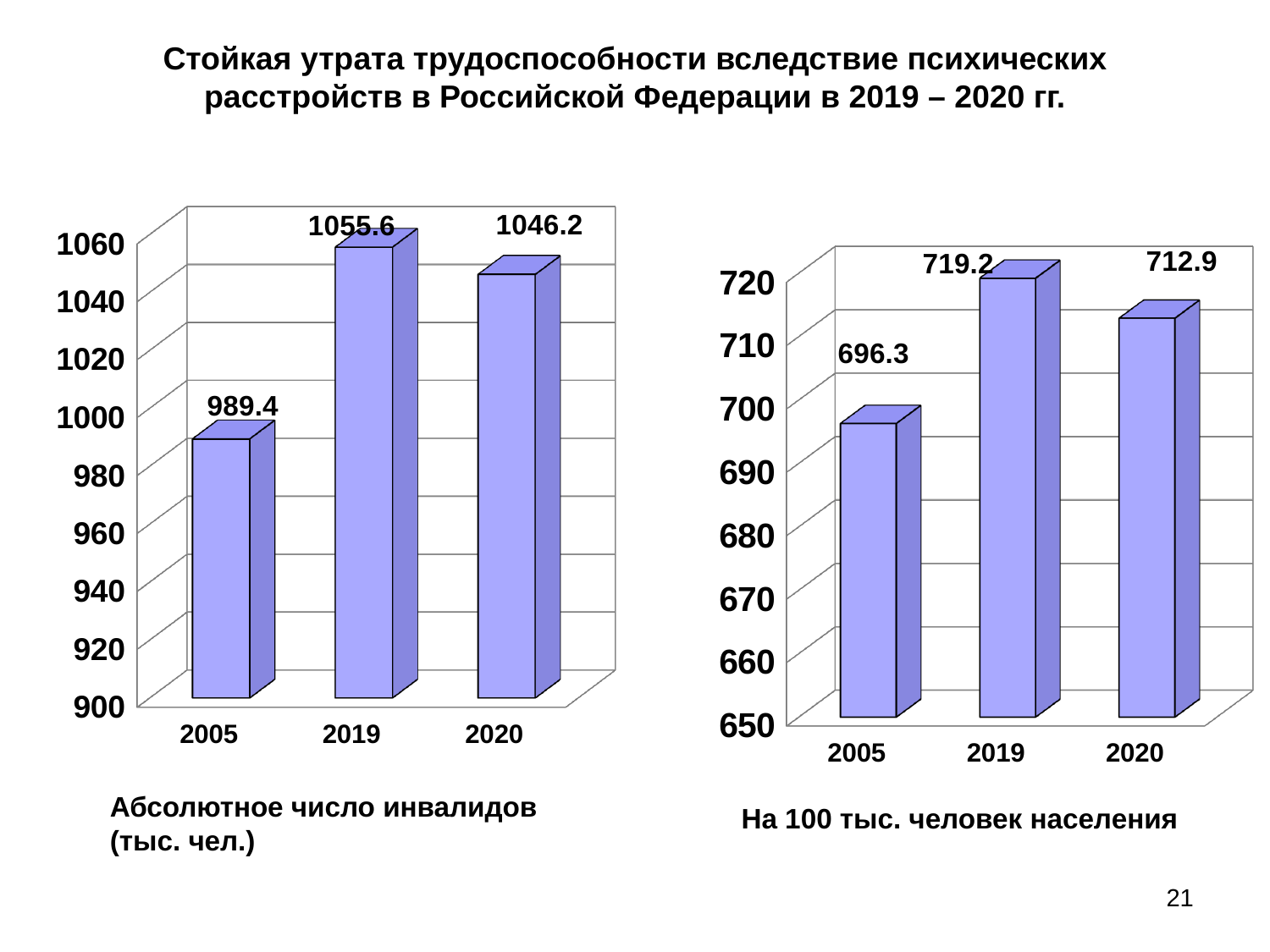
In the left chart (Абсолютное число инвалидов), what is the value for 2005? 989.4 In the left chart (Абсолютное число инвалидов), what is the value for 2019? 1055.6 In the right chart (На 100 тыс. человек населения), which year has the lowest value? 2005 In the left chart (Абсолютное число инвалидов), is the value for 2005 greater or less than 1000? less In the right chart (На 100 тыс. человек населения), does the value rise or fall from 2019 to 2020? fall In the right chart (На 100 тыс. человек населения), which is larger, the value for 2019 or the value for 2020? 2019 What kind of chart is the left chart (Абсолютное число инвалидов)? bar chart In the right chart (На 100 тыс. человек населения), what is the difference between the 2019 and 2005 values? 22.9 How many years are shown on the x axis of the right chart (На 100 тыс. человек населения)? 3 In the right chart (На 100 тыс. человек населения), what is the value for 2020? 712.9 In the left chart (Абсолютное число инвалидов), what is the difference between the 2019 and 2020 values? 9.4 In the left chart (Абсолютное число инвалидов), which year has the highest value? 2019